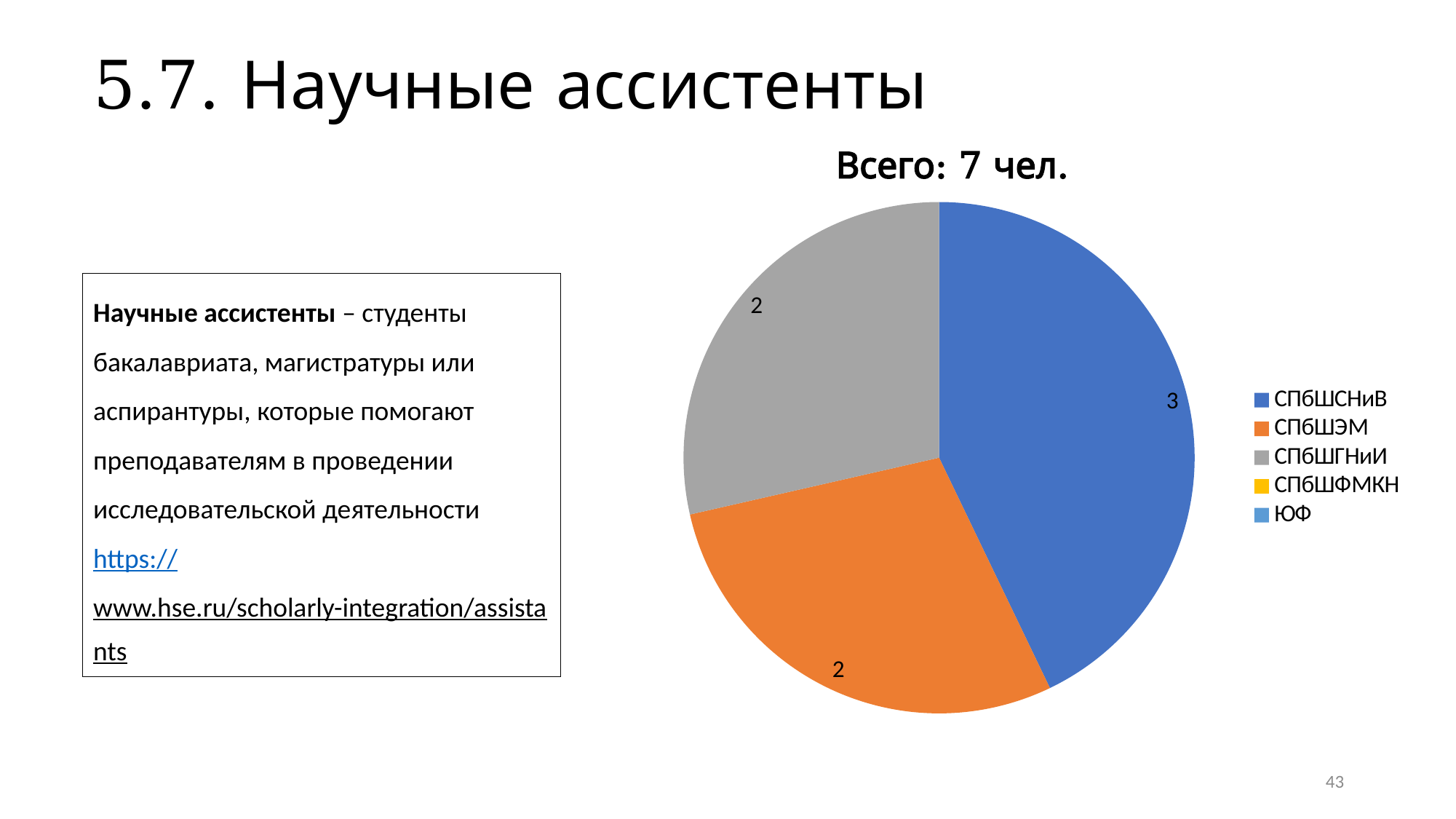
Which category has the largest slice in the pie chart? СПбШСНиВ What is the value for СПбШГНиИ in the pie chart? 2 What is the value for СПбШСНиВ in the pie chart? 3 Which is larger, the value for СПбШСНиВ or the value for СПбШЭМ? СПбШСНиВ What is the title of the pie chart? Всего: 7 чел. What is the value for СПбШЭМ in the pie chart? 2 What is the difference between the value for СПбШСНиВ and the value for СПбШГНиИ? 1 What type of chart is shown on the slide? pie chart What colour is the slice for СПбШЭМ in the pie chart? orange How many slices are visible in the pie chart? 3 How many entries does the legend of the pie chart list? 5 What is the total number of people shown in the pie chart? 7